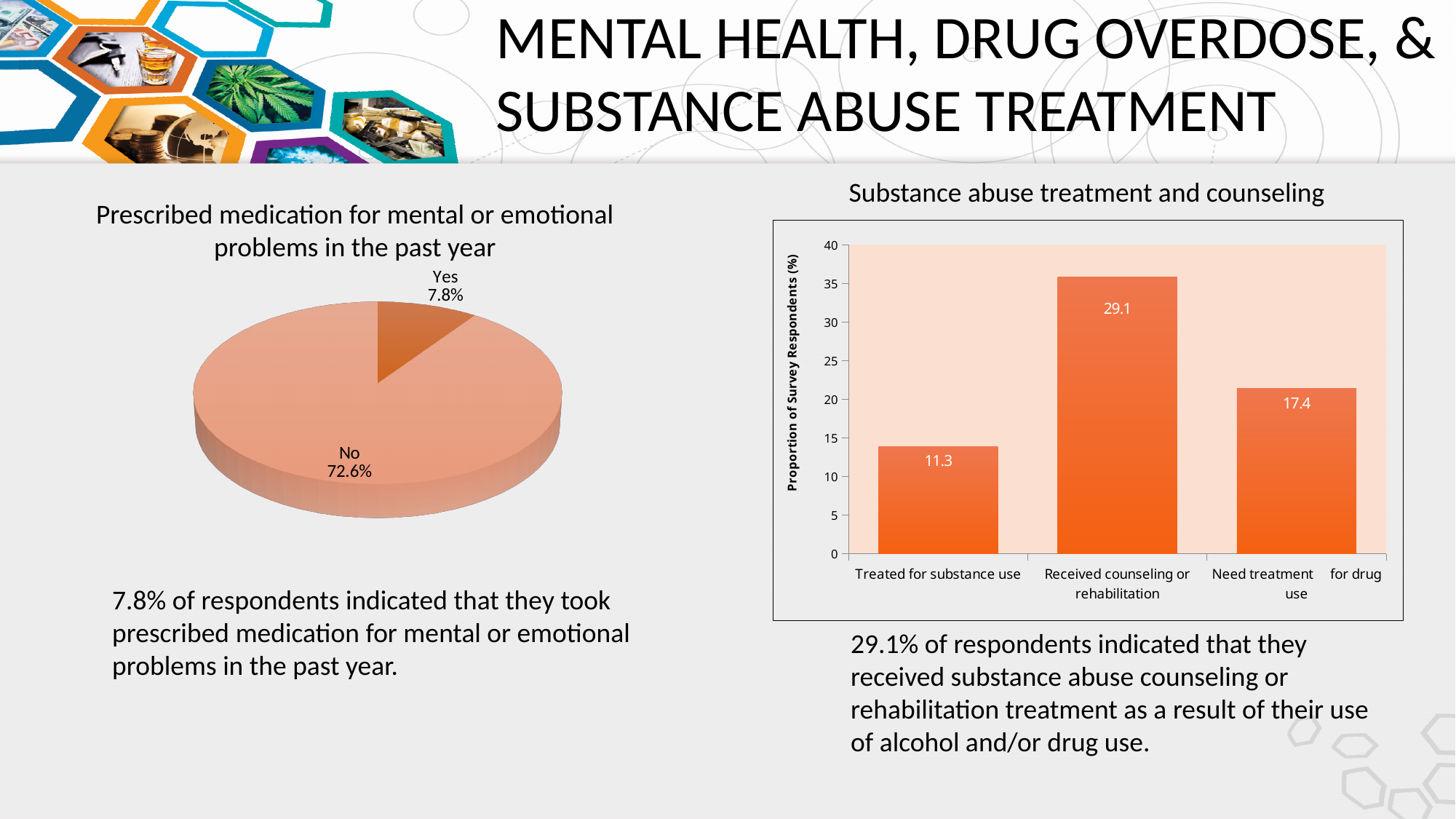
In the pie chart 'Prescribed medication for mental or emotional problems in the past year', what percentage is shown for 'No'? 72.6% In the 'Substance abuse treatment and counseling' chart, what is the difference between the values for 'Received counseling or rehabilitation' and 'Treated for substance use'? 17.8 In the 'Substance abuse treatment and counseling' chart, which category has the highest value? Received counseling or rehabilitation In the 'Substance abuse treatment and counseling' chart, what is the value for 'Need treatment for drug use'? 17.4 In the 'Substance abuse treatment and counseling' chart, what is the value for 'Treated for substance use'? 11.3 In the pie chart 'Prescribed medication for mental or emotional problems in the past year', what percentage is shown for 'Yes'? 7.8% In the 'Substance abuse treatment and counseling' chart, what is the value for 'Received counseling or rehabilitation'? 29.1 What kind of chart is 'Substance abuse treatment and counseling'? Bar chart In the pie chart on the left, which slice is larger, 'Yes' or 'No'? No In the 'Substance abuse treatment and counseling' chart, which category has the lowest value? Treated for substance use How many slices does the pie chart on the left have? 2 What kind of chart is the chart on the left of the slide? Pie chart